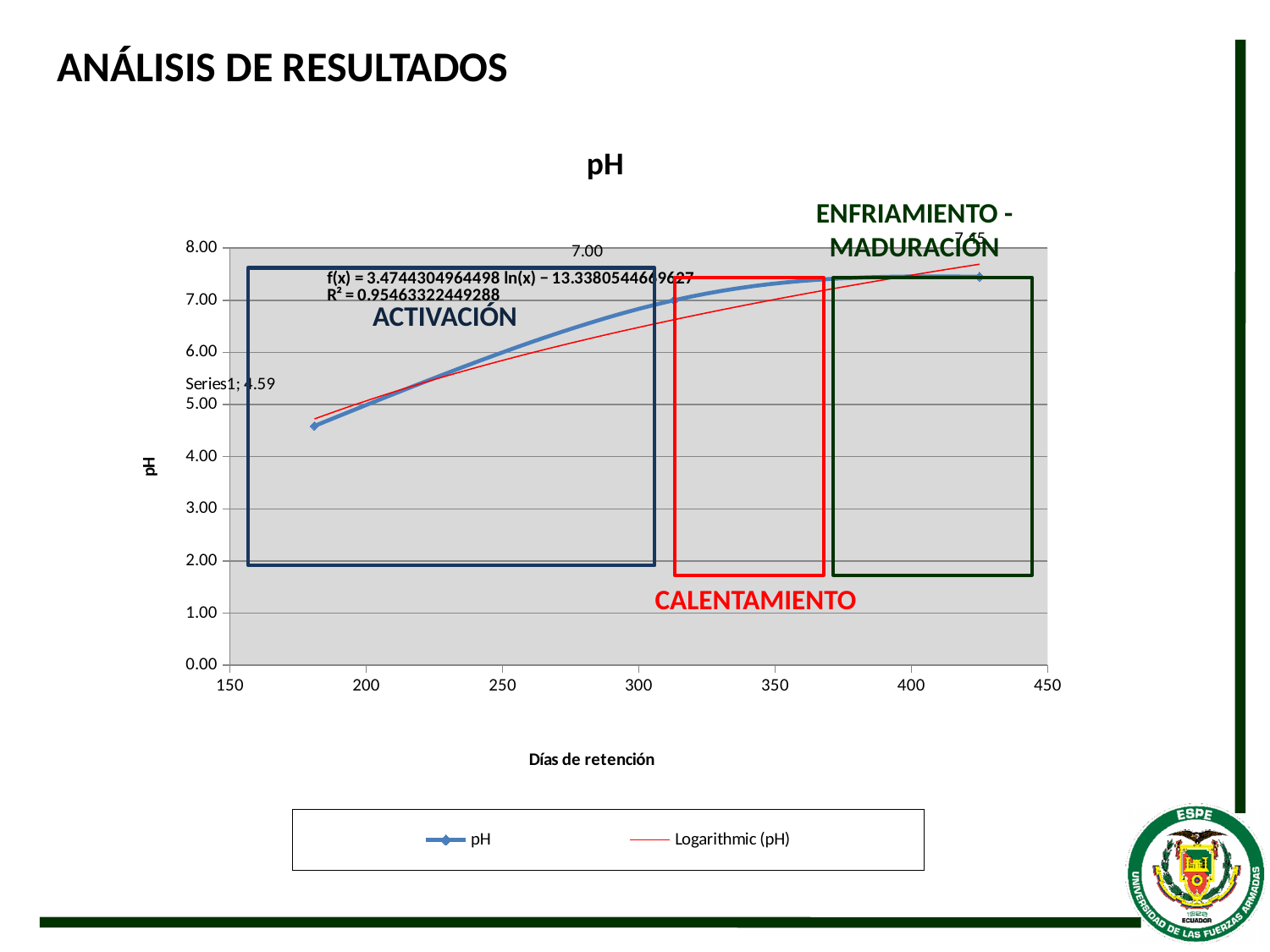
How many data points are plotted on the pH line? 3 What is the highest pH value labeled on the chart? 7.45 How many series does the legend list? 2 Does the pH rise or fall as the days of retention increase? rise Is the pH value of the first data point greater or less than 5.00? less What R² value is shown for the logarithmic trendline? 0.95463322449288 What is the lowest pH value labeled on the chart? 4.59 What is the pH value labeled on the middle data point of the line? 7.00 What is the title of the x axis? Días de retención What kind of chart is shown on the slide? line chart What is the difference between the pH labeled 7.00 and the first data point value of 4.59? 2.41 What is the pH value of the first (leftmost) data point? 4.59